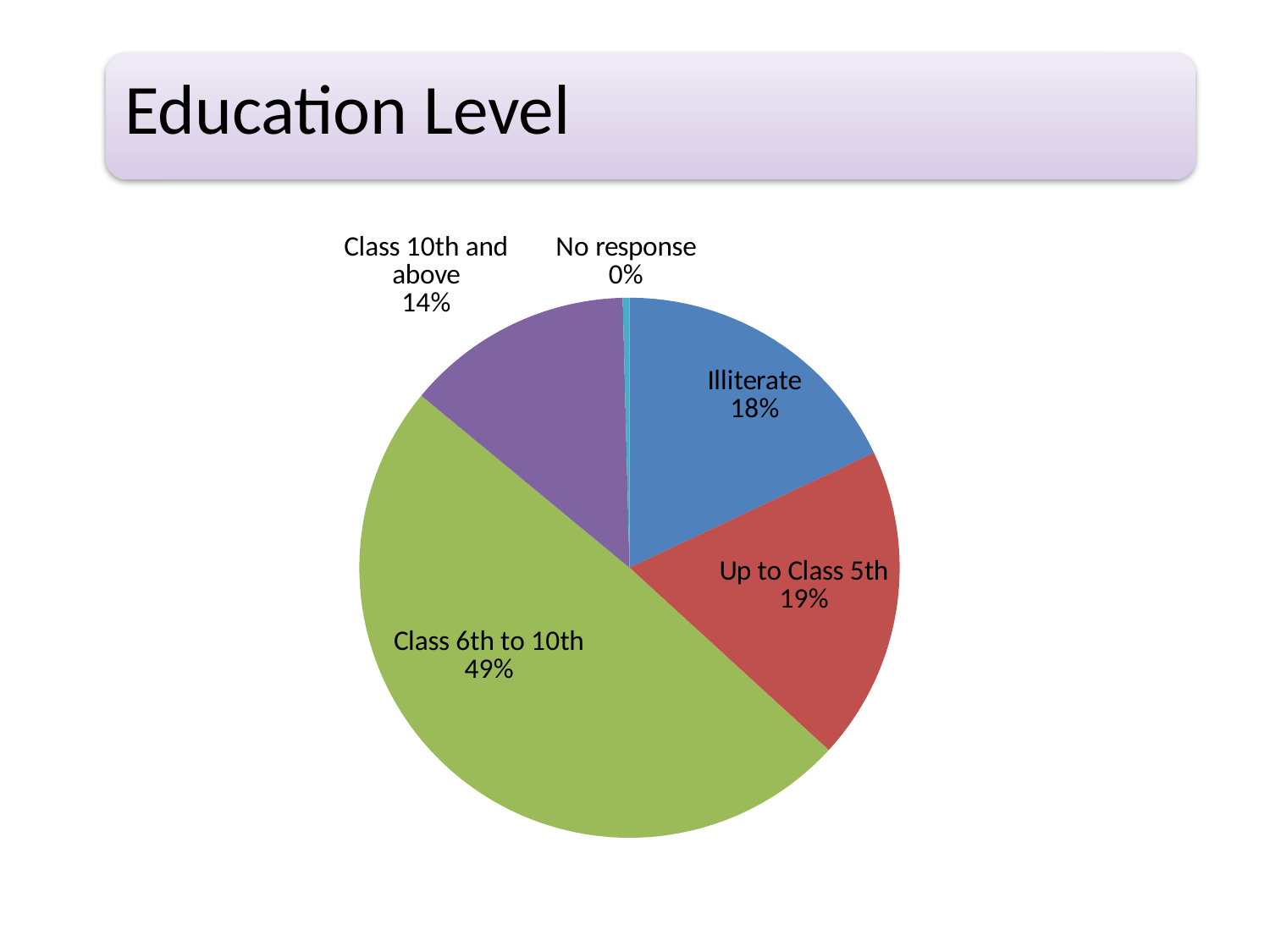
What is the difference between the Class 6th to 10th share and the Class 10th and above share? 35% Which is larger, the Illiterate slice or the Class 10th and above slice? Illiterate Which category has the smallest slice of the pie? No response What kind of chart is shown on the slide? pie chart What is the value for No response? 0% What is the value for Illiterate? 18% How many categories are shown in the pie chart? 5 What is the value for Class 10th and above? 14% What share of the pie is Class 6th to 10th? 49% What is the value for Up to Class 5th? 19% What is the title of the slide containing the pie chart? Education Level Which category has the largest slice of the pie? Class 6th to 10th